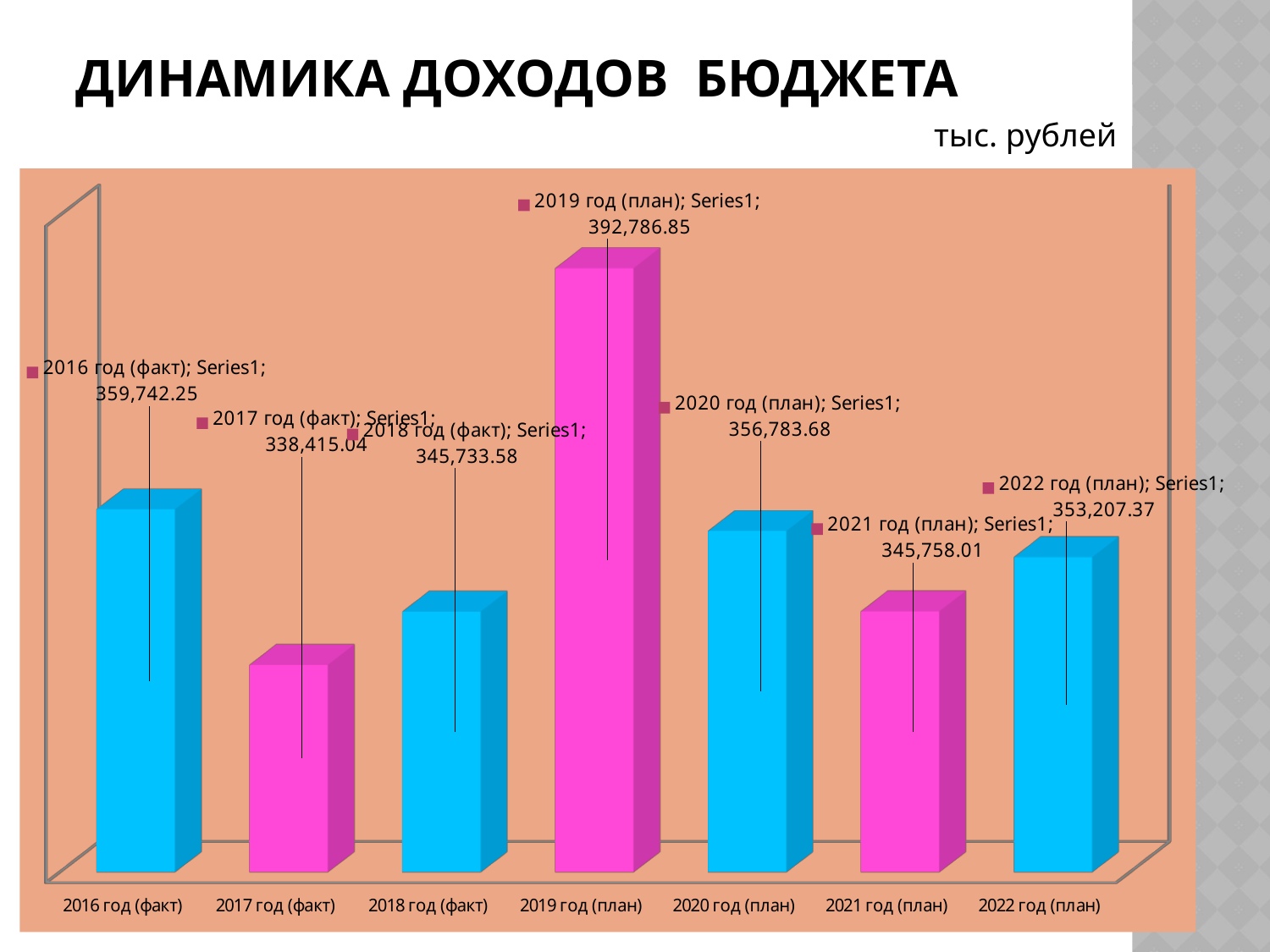
Which is larger, the value for 2022 год (план) or the value for 2017 год (факт)? 2022 год (план) Which category has the highest value? 2019 год (план) What is the value for 2017 год (факт)? 338,415.04 What is the title of the chart? ДИНАМИКА ДОХОДОВ БЮДЖЕТА What kind of chart is shown on the slide? Bar chart What is the value for 2020 год (план)? 356,783.68 What is the difference between the values for 2016 год (факт) and 2017 год (факт)? 21,327.21 What is the value for 2019 год (план)? 392,786.85 What is the value for 2022 год (план)? 353,207.37 Which category has the lowest value? 2017 год (факт) What is the difference between the values for 2019 год (план) and 2017 год (факт)? 54,371.81 How many categories are shown on the chart? 7